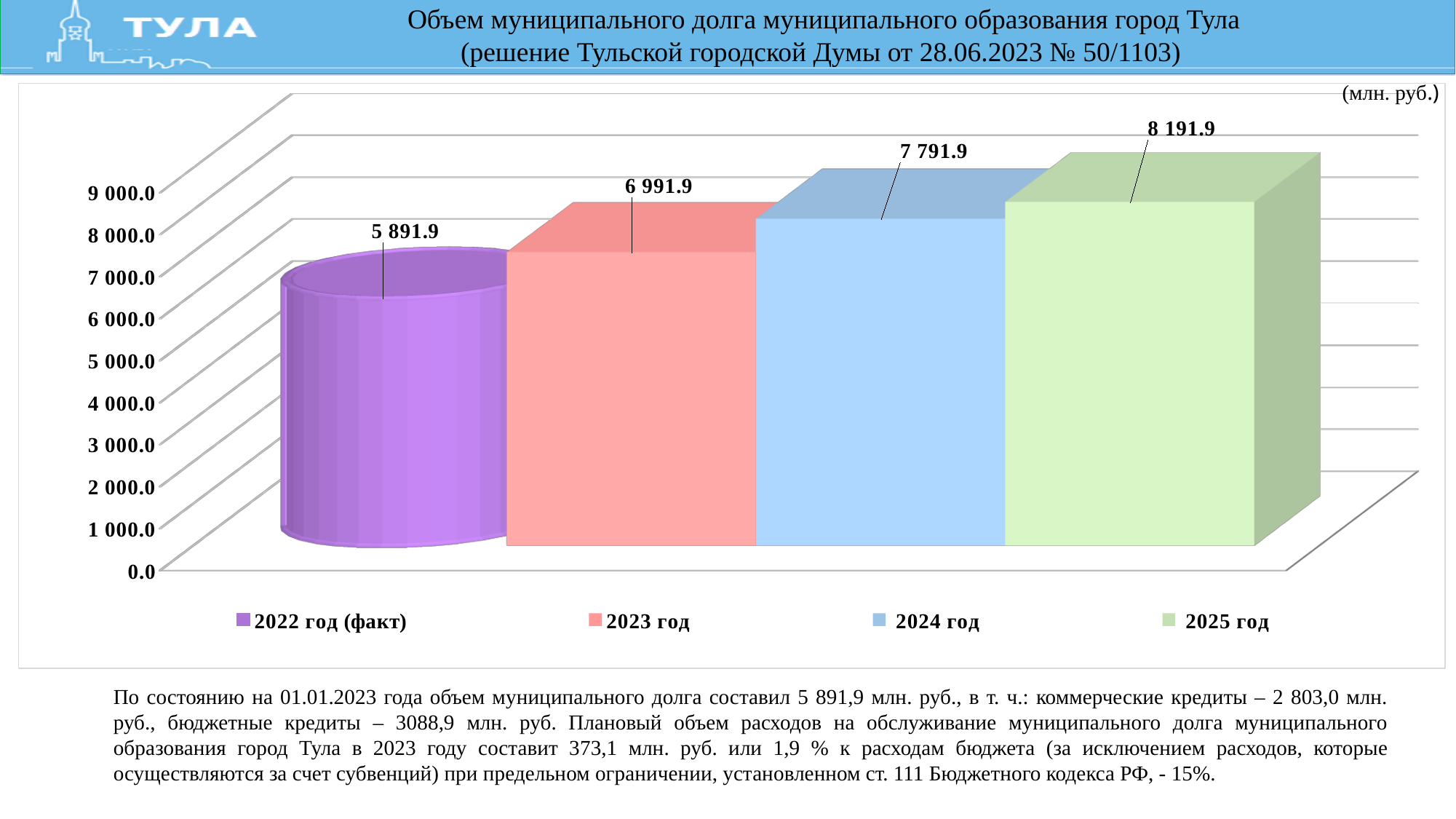
What is the value for 2023 год? 6 991.9 Which is larger, the value for 2024 год or the value for 2023 год? 2024 год What unit is shown in the top right corner of the chart? млн. руб. Do the values rise or fall from 2022 to 2025? rise What is the difference between the values for 2023 год and 2022 год (факт)? 1 100.0 What is the difference between the values for 2025 год and 2024 год? 400.0 What is the value for 2024 год? 7 791.9 What is the value for 2025 год? 8 191.9 Which year has the lowest value? 2022 год (факт) Which year has the highest value? 2025 год What is the value for 2022 год (факт)? 5 891.9 How many years are plotted in the chart? 4